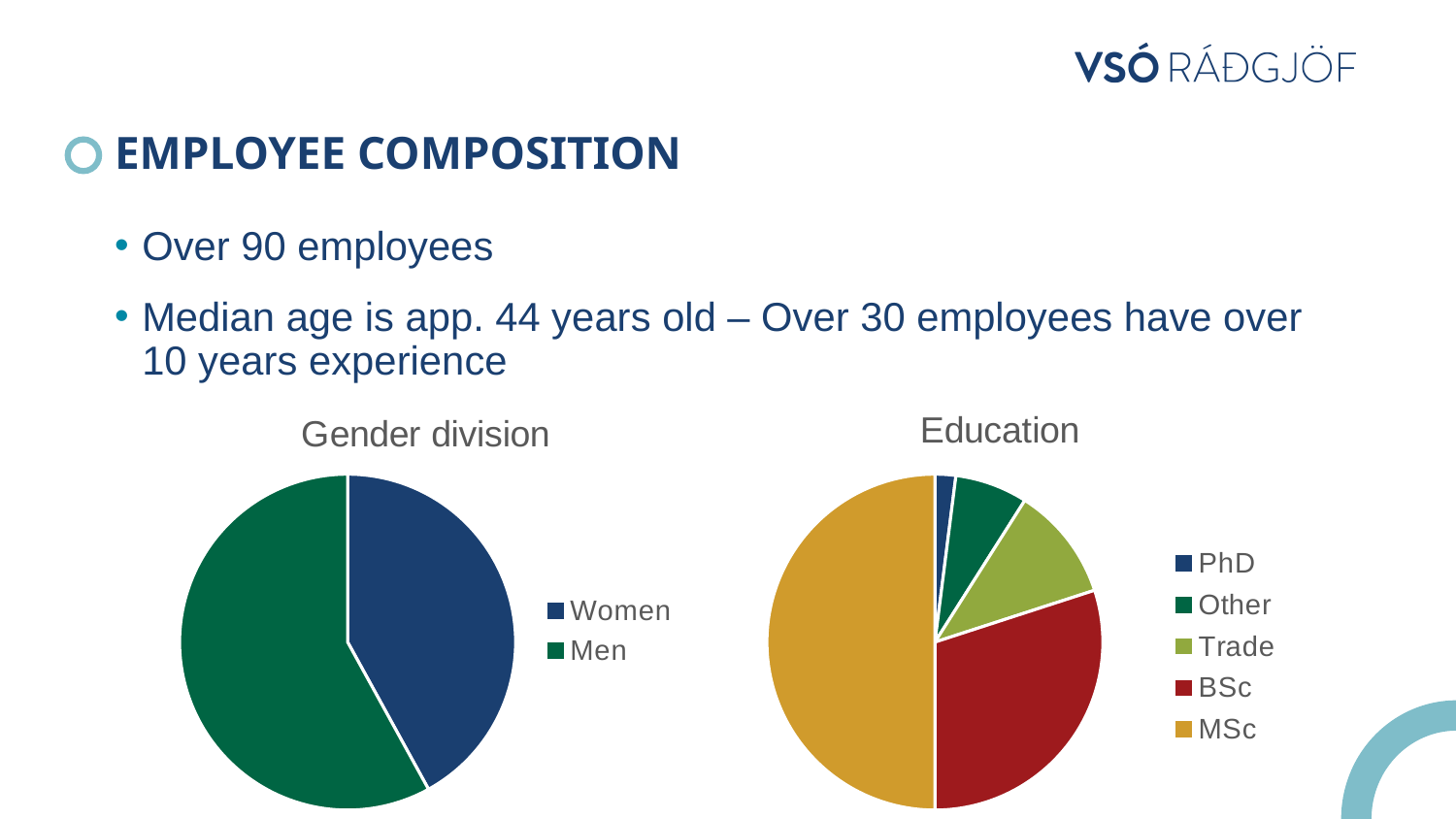
In the "Education" chart, which category has the smallest share? PhD In the "Education" chart, what colour is the MSc slice? Gold/yellow In the "Gender division" chart, which category has the smaller share? Women In the "Education" chart, which category has the largest share? MSc In the "Gender division" chart, which category has the larger share? Men What is the title of the pie chart on the right of the slide? Education In the "Education" chart, which is larger, the BSc slice or the Trade slice? BSc In the "Education" chart, which is larger, the Trade slice or the Other slice? Trade What kind of chart is the "Gender division" chart? Pie chart In the "Education" chart, how many categories does the legend list? 5 In the "Gender division" chart, how many categories does the legend list? 2 What kind of chart is the "Education" chart? Pie chart